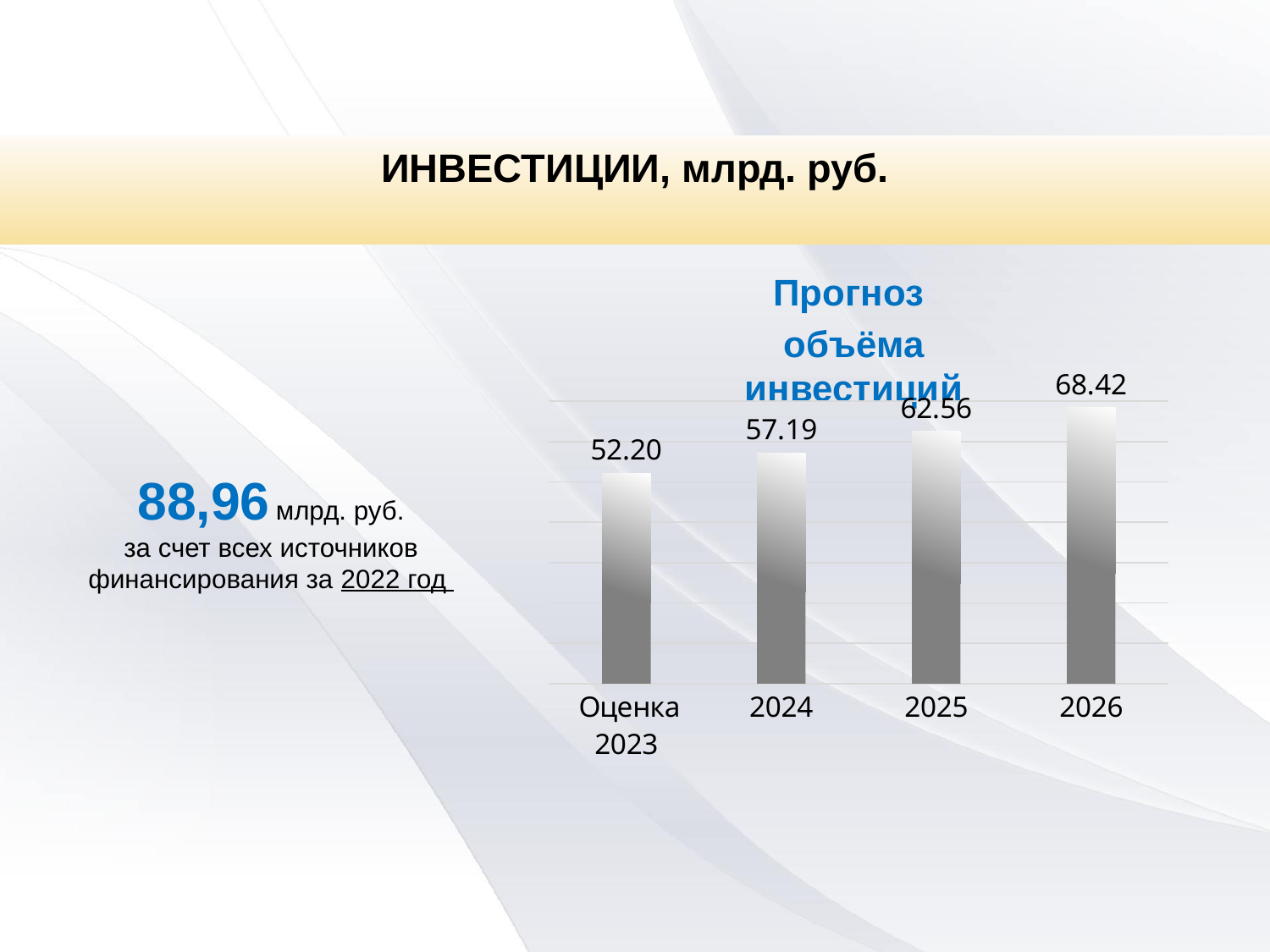
How many categories are shown on the chart? 4 What is the value for 2025? 62.56 What is the difference between the values for 2025 and 2024? 5.37 What is the value for 2024? 57.19 Which is larger, the value for 2024 or the value for 2025? 2025 Which category has the highest value? 2026 What is the value for 2026? 68.42 Which category has the lowest value? Оценка 2023 What kind of chart is shown on the slide? Bar chart Do the values rise or fall from Оценка 2023 to 2026? Rise What is the value for Оценка 2023? 52.20 What is the difference between the values for 2026 and Оценка 2023? 16.22